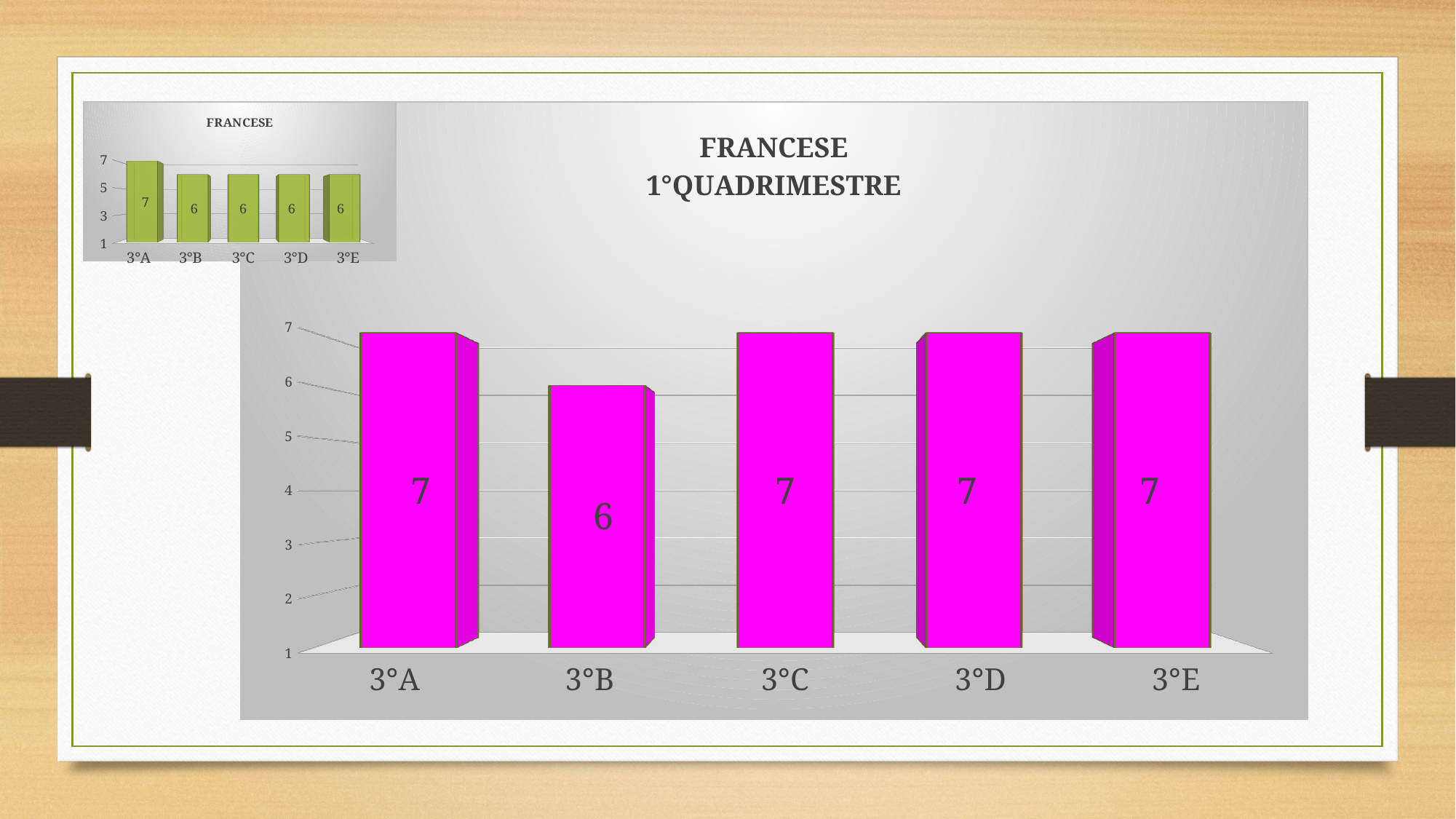
In the large chart titled FRANCESE 1°QUADRIMESTRE, what is the difference between the values for 3°A and 3°B? 1 What colour are the bars in the large chart titled FRANCESE 1°QUADRIMESTRE? magenta What kind of chart is the large chart titled FRANCESE 1°QUADRIMESTRE? bar chart In the large chart titled FRANCESE 1°QUADRIMESTRE, what is the value for 3°A? 7 In the large chart titled FRANCESE 1°QUADRIMESTRE, how many categories are shown on the x axis? 5 In the small chart titled FRANCESE in the top-left corner, what is the value for 3°E? 6 In the small chart titled FRANCESE in the top-left corner, what is the difference between the values for 3°A and 3°C? 1 In the large chart titled FRANCESE 1°QUADRIMESTRE, which is larger, the value for 3°C or the value for 3°B? 3°C In the large chart titled FRANCESE 1°QUADRIMESTRE, what is the value for 3°B? 6 In the small chart titled FRANCESE in the top-left corner, what is the value for 3°A? 7 In the large chart titled FRANCESE 1°QUADRIMESTRE, which category has the lowest value? 3°B In the small chart titled FRANCESE in the top-left corner, which category has the highest value? 3°A